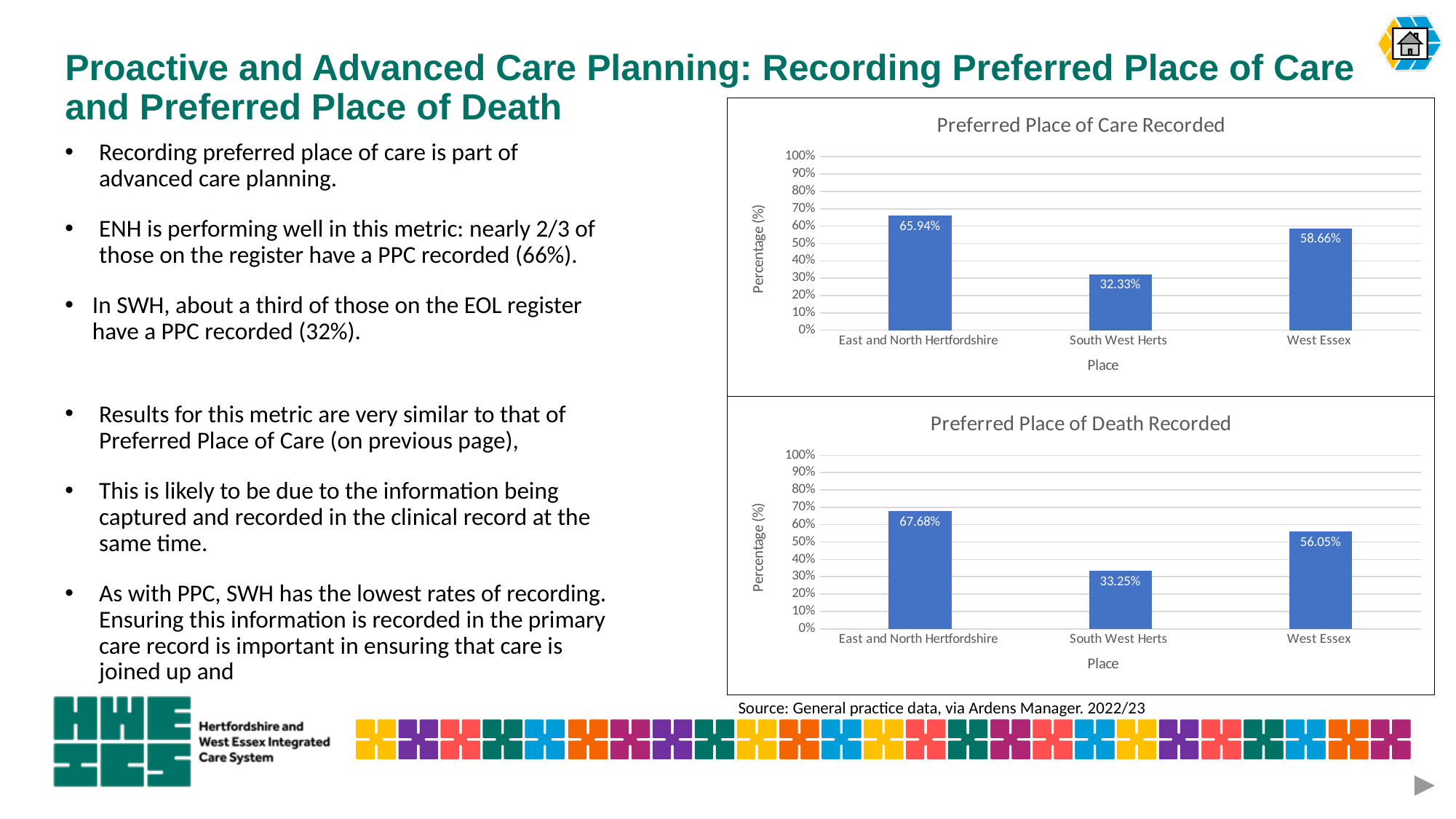
In the 'Preferred Place of Care Recorded' chart, which place has the highest value? East and North Hertfordshire How many places are shown in the 'Preferred Place of Death Recorded' chart? 3 In the 'Preferred Place of Death Recorded' chart, which place has the lowest value? South West Herts In the 'Preferred Place of Care Recorded' chart, is the value for West Essex greater or less than 50%? greater In the 'Preferred Place of Death Recorded' chart, what is the value for West Essex? 56.05% What type of chart is the 'Preferred Place of Care Recorded' chart? Bar chart In the 'Preferred Place of Death Recorded' chart, which is larger: the value for West Essex or the value for South West Herts? West Essex In the 'Preferred Place of Care Recorded' chart, what is the value for East and North Hertfordshire? 65.94% In the 'Preferred Place of Death Recorded' chart, what is the value for East and North Hertfordshire? 67.68% In the 'Preferred Place of Care Recorded' chart, what is the difference between the values for East and North Hertfordshire and West Essex? 7.28% In the 'Preferred Place of Death Recorded' chart, what is the difference between the values for East and North Hertfordshire and South West Herts? 34.43% In the 'Preferred Place of Care Recorded' chart, what is the value for South West Herts? 32.33%